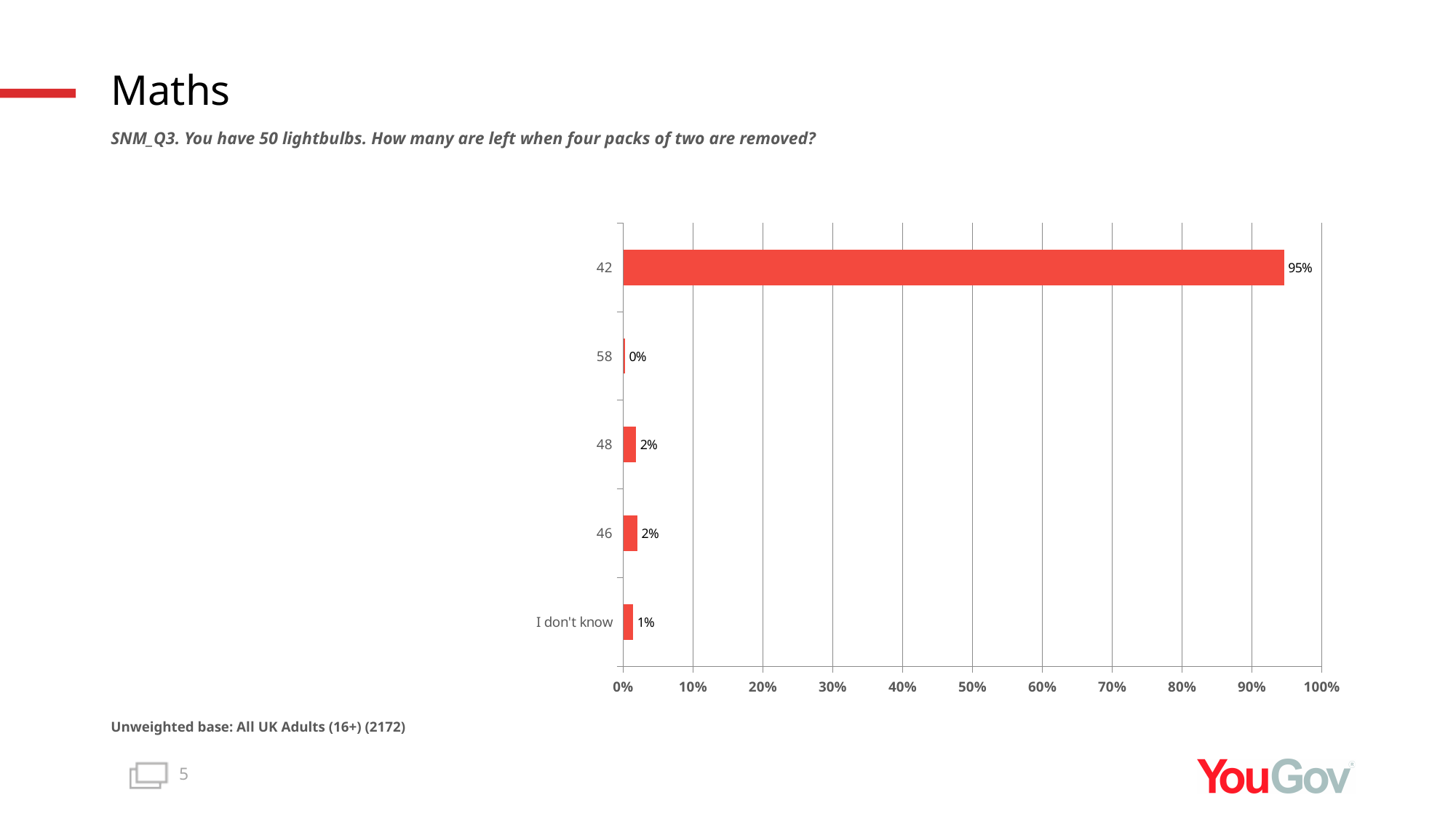
Which has a larger percentage, the answer 48 or 'I don't know'? 48 What is the survey question shown above the chart? SNM_Q3. You have 50 lightbulbs. How many are left when four packs of two are removed? What percentage of respondents said 'I don't know'? 1% Which answer option has the highest percentage? 42 What is the difference in percentage points between the answer 42 and the answer 46? 93 What kind of chart is shown on the slide? Bar chart What percentage of respondents answered 42? 95% Which answer option has the lowest percentage? 58 What percentage of respondents answered 48? 2% Is the value for the answer 42 greater or less than 90%? greater How many answer options are shown on the chart? 5 What percentage of respondents answered 58? 0%